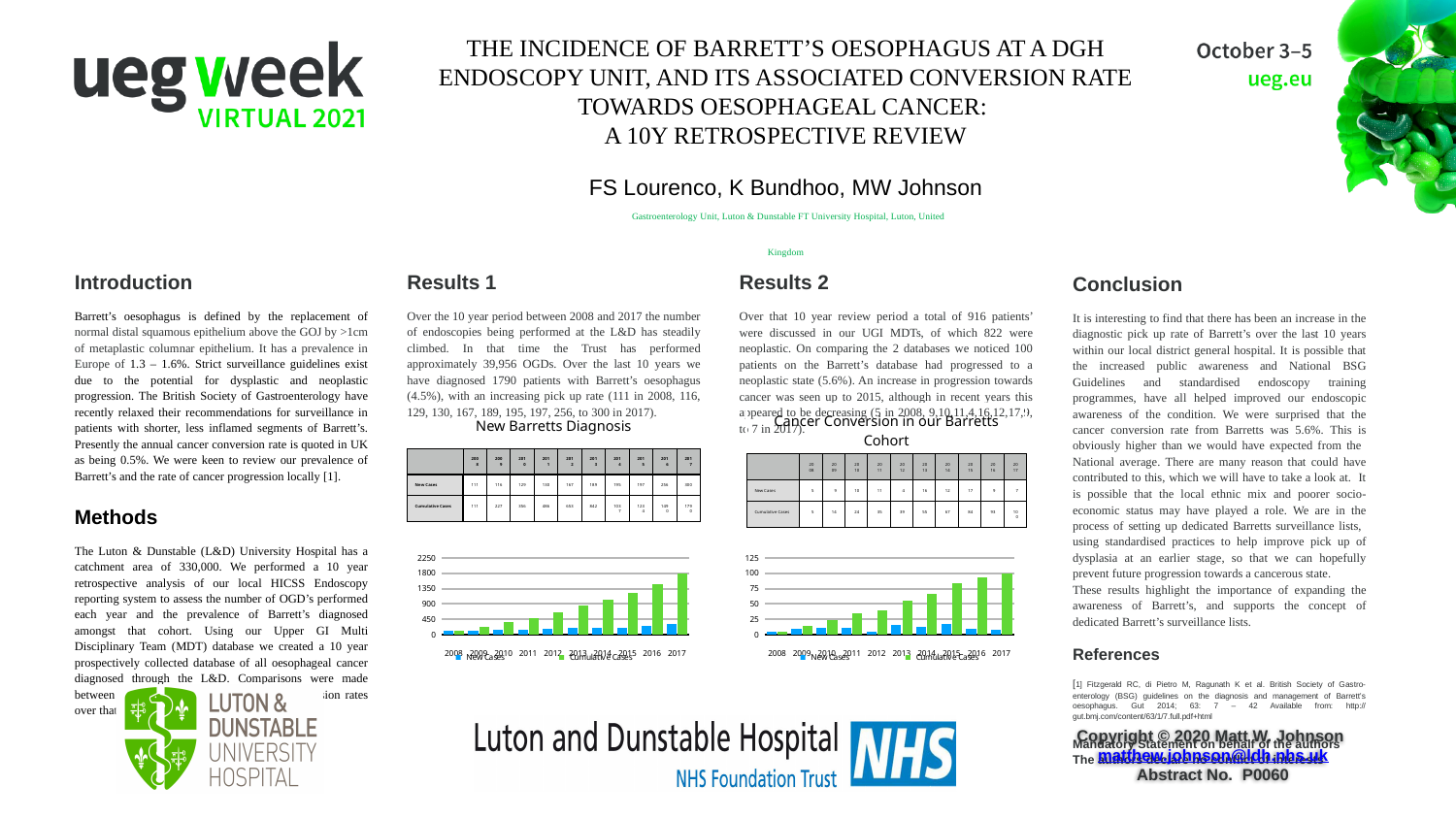
In the 'Cancer Conversion in our Barretts Cohort' chart, is the cumulative cases value for 2017 greater or less than 75? greater In the 'Cancer Conversion in our Barretts Cohort' chart, which year has the highest number of new cases? 2015 What type of chart is the 'New Barretts Diagnosis' chart? bar chart In the 'New Barretts Diagnosis' chart, what is the number of new cases in 2017? 300 In the 'New Barretts Diagnosis' chart, how many years are shown on the x axis? 10 In the 'New Barretts Diagnosis' chart, which year has the highest number of new cases? 2017 In the 'New Barretts Diagnosis' chart, how many series does the legend list? 2 In the 'New Barretts Diagnosis' chart, what is the number of new cases in 2008? 111 In the 'Cancer Conversion in our Barretts Cohort' chart, which year has the lowest number of new cases? 2012 In the 'New Barretts Diagnosis' chart, is the cumulative cases value for 2017 greater or less than 1350? greater In the 'New Barretts Diagnosis' chart, do the cumulative cases rise or fall from 2008 to 2017? rise In the 'New Barretts Diagnosis' chart, what is the difference in new cases between 2017 and 2016? 44